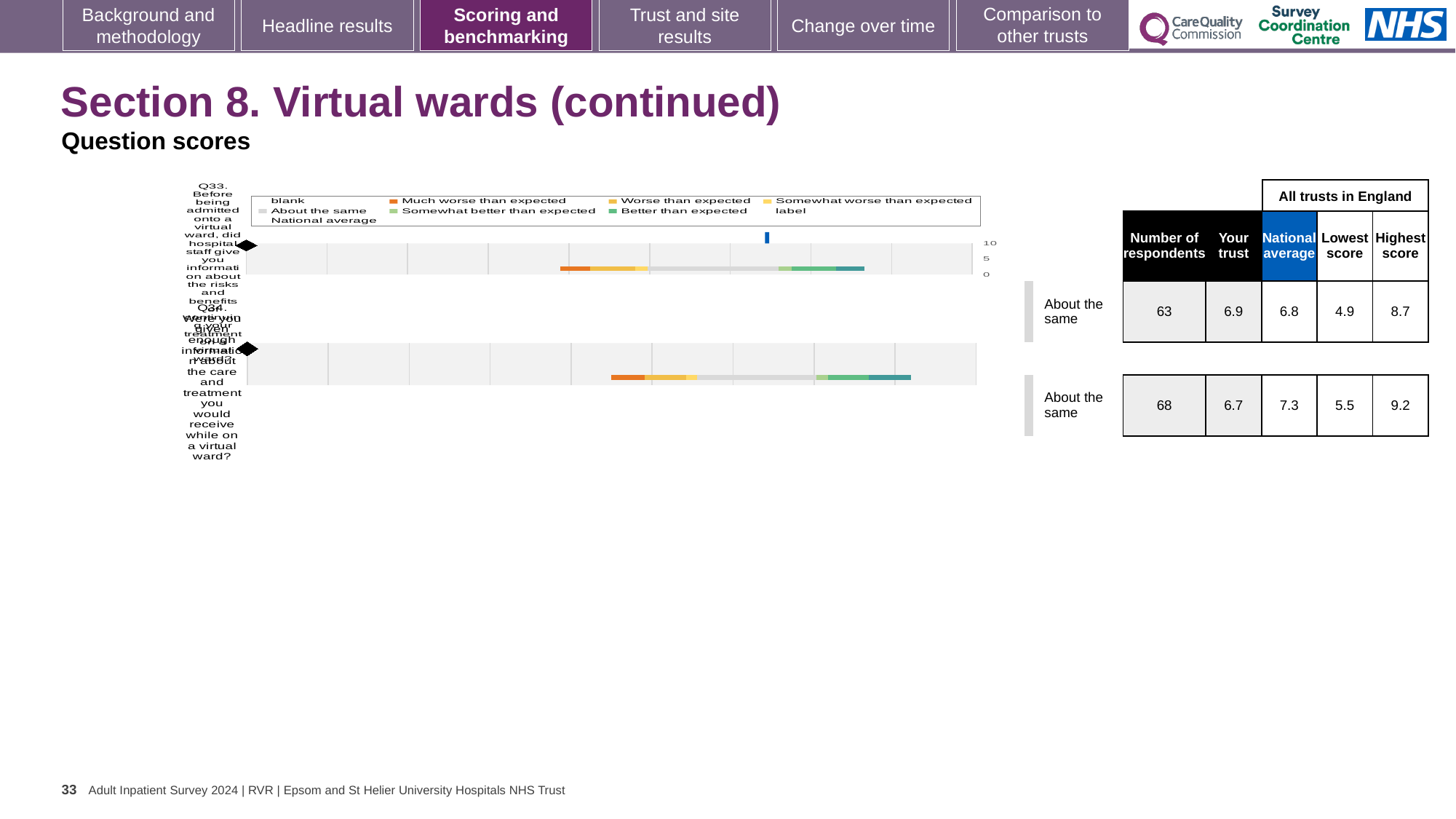
For Q34, is the 'Your trust' score or the national average higher? National average Which question had more respondents, Q33 or Q34? Q34 What is the difference between the highest score and the lowest score for Q33? 3.8 How many respondents answered Q33? 63 How many questions are plotted in the chart on this slide? 2 What is the national average score for Q34? 7.3 Which colour in the chart legend represents 'Much worse than expected'? Orange What benchmark category is shown next to the Q33 bar? About the same What benchmark category is shown next to the Q34 bar? About the same What is the 'Your trust' score for Q33? 6.9 What is the difference between the highest score and the lowest score for Q34? 3.7 What kind of chart is used to show the question scores on this slide? Bar chart